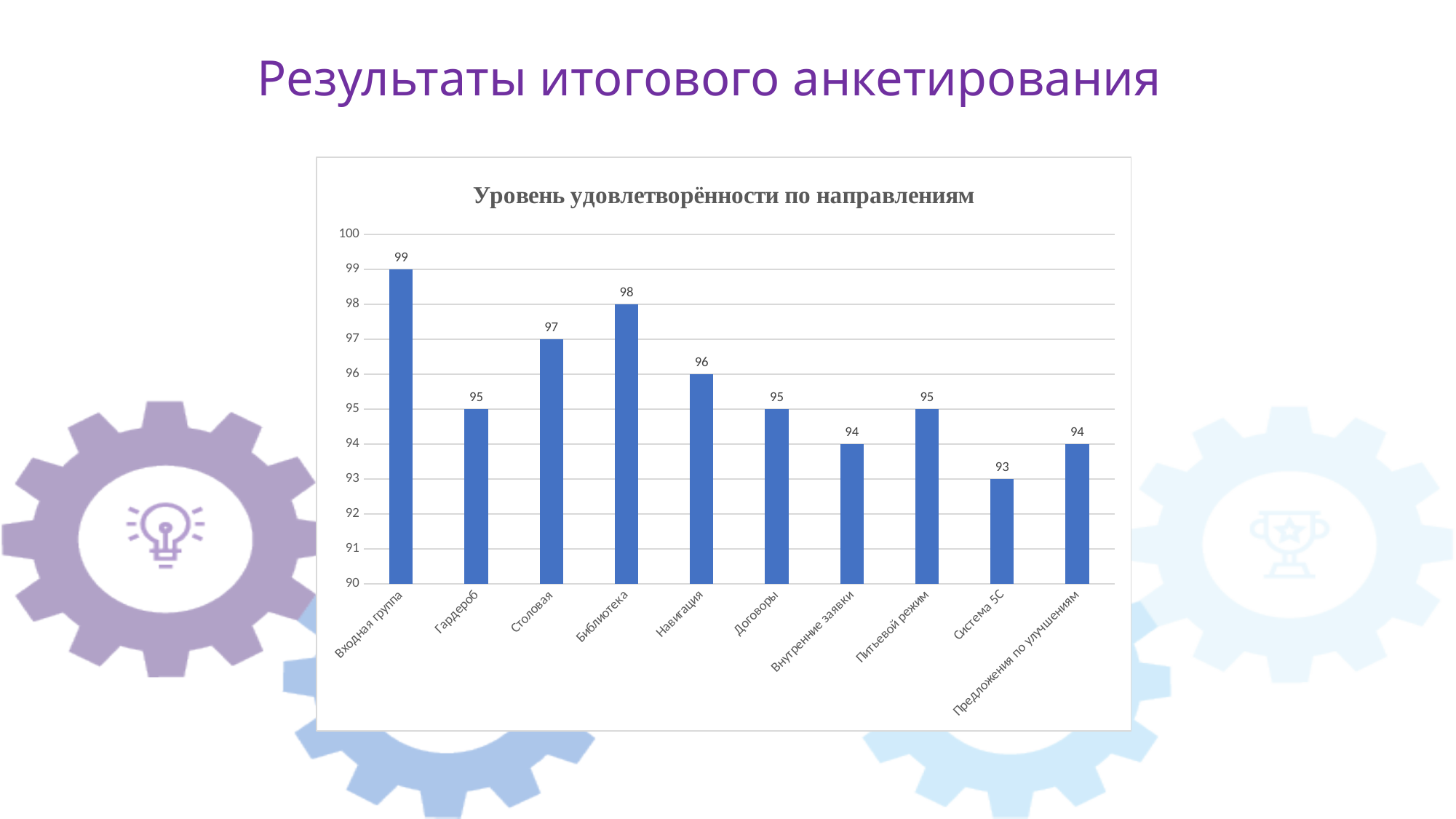
Which category has the highest value? Входная группа What is the value for Предложения по улучшениям? 94 Which is larger, the value for Столовая or the value for Навигация? Столовая Which category has the lowest value? Система 5С What is the title of the chart? Уровень удовлетворённости по направлениям What is the difference between the values for Входная группа and Система 5С? 6 What is the value for Входная группа? 99 What kind of chart is shown? bar chart What is the value for Система 5С? 93 How many categories are shown on the x axis? 10 What is the difference between the values for Библиотека and Гардероб? 3 What is the value for Библиотека? 98